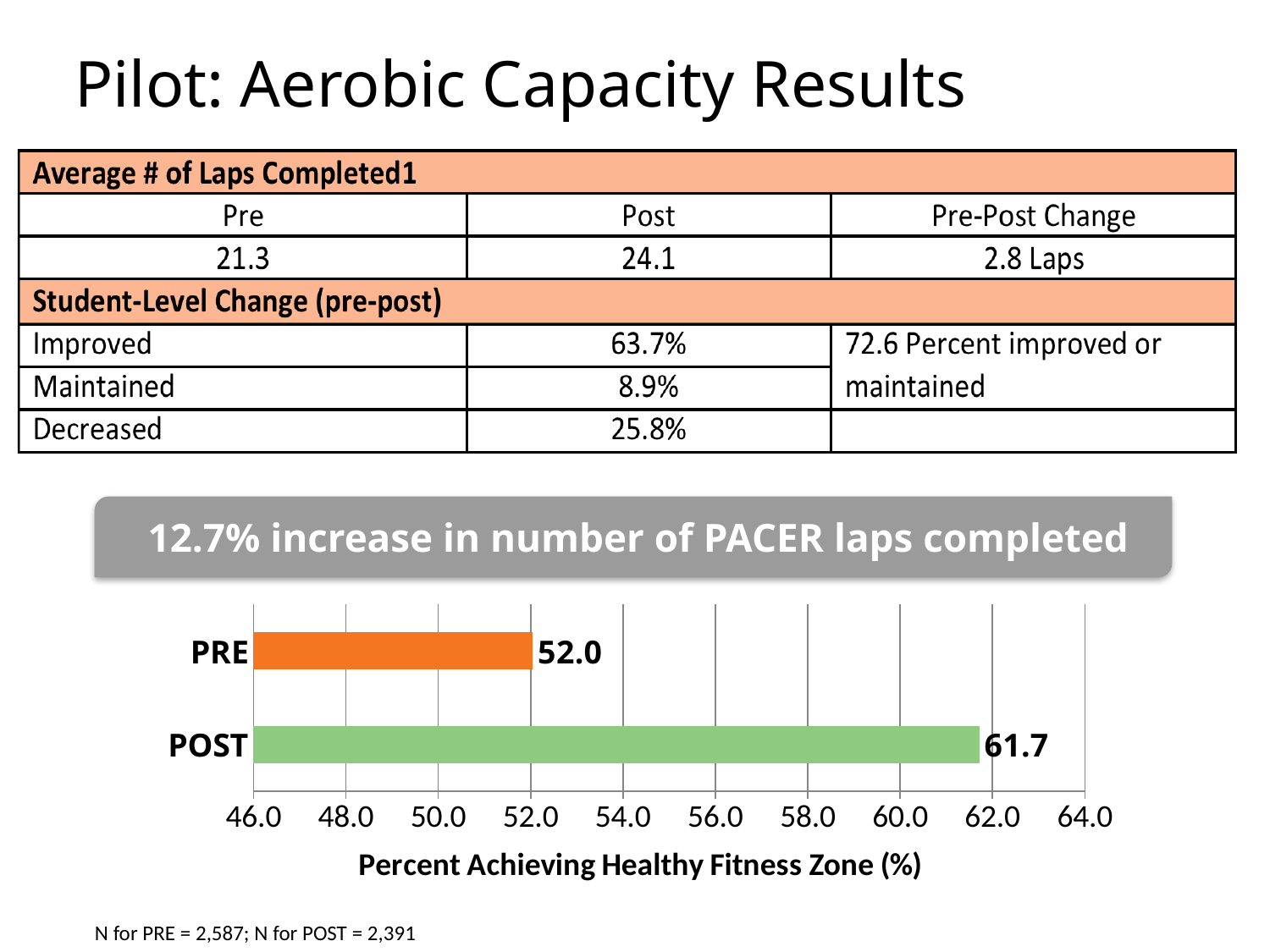
Which category has the lowest value in the bar chart? PRE What kind of chart is shown on the slide? bar chart What colour is the POST bar in the bar chart? green Is the value for POST in the bar chart greater or less than 60.0? greater What is the value for POST in the bar chart? 61.7 How many categories are shown in the bar chart? 2 What is the difference between the POST and PRE values in the bar chart? 9.7 Is the value for PRE in the bar chart greater or less than 54.0? less What is the x-axis title of the bar chart? Percent Achieving Healthy Fitness Zone (%) What is the value for PRE in the bar chart? 52.0 Which category has the higher value in the bar chart, PRE or POST? POST